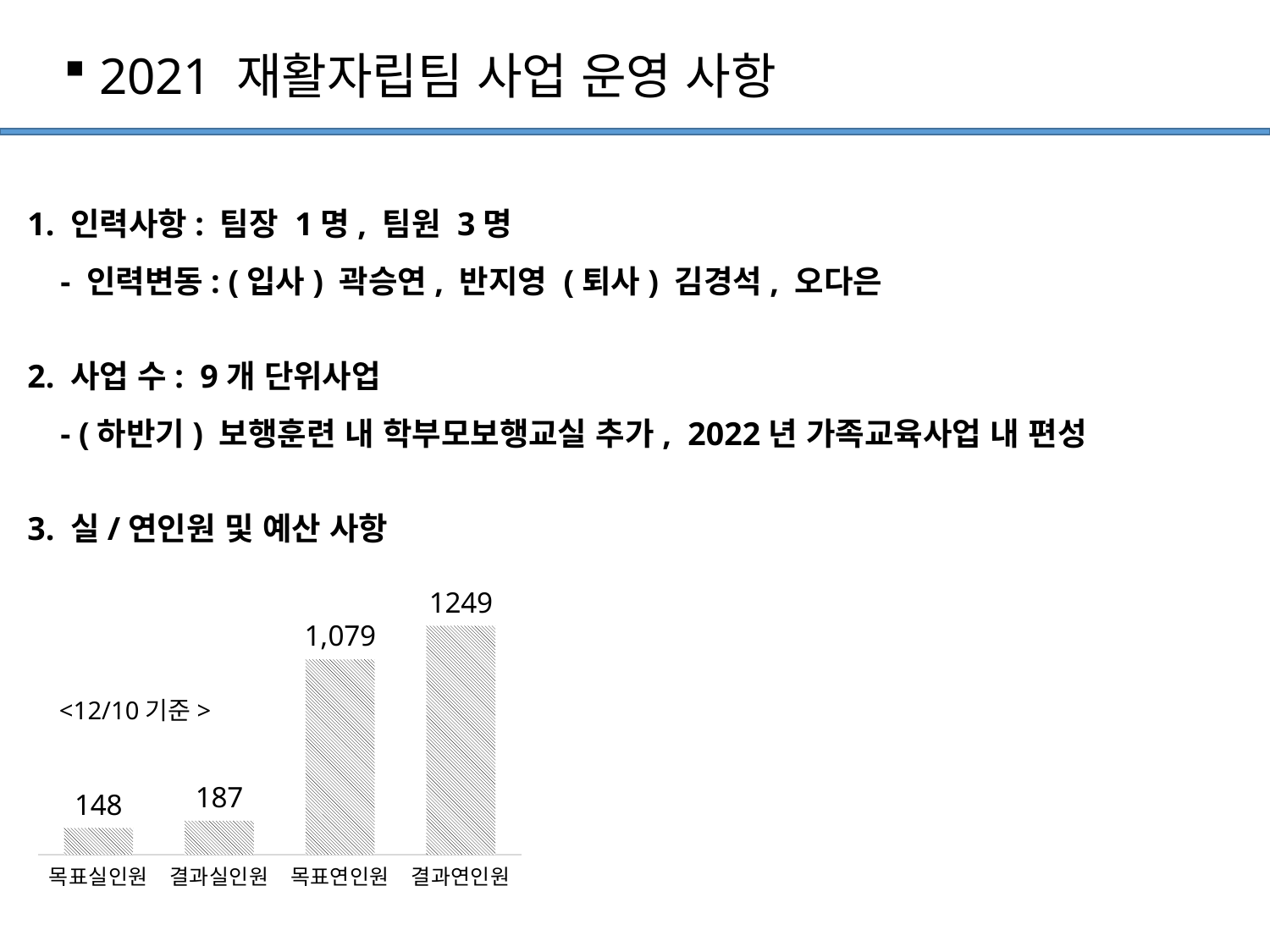
What is the difference between 결과연인원 and 목표연인원? 170 What is the value for 결과실인원? 187 What is the value for 목표실인원? 148 Which is larger, 목표연인원 or 결과연인원? 결과연인원 How many categories are shown in the chart? 4 Which category has the highest value? 결과연인원 What reference date note is printed next to the chart? <12/10 기준 > What is the difference between 결과실인원 and 목표실인원? 39 What is the value for 결과연인원? 1249 What kind of chart is shown on the slide? bar chart What is the value for 목표연인원? 1,079 Which category has the lowest value? 목표실인원